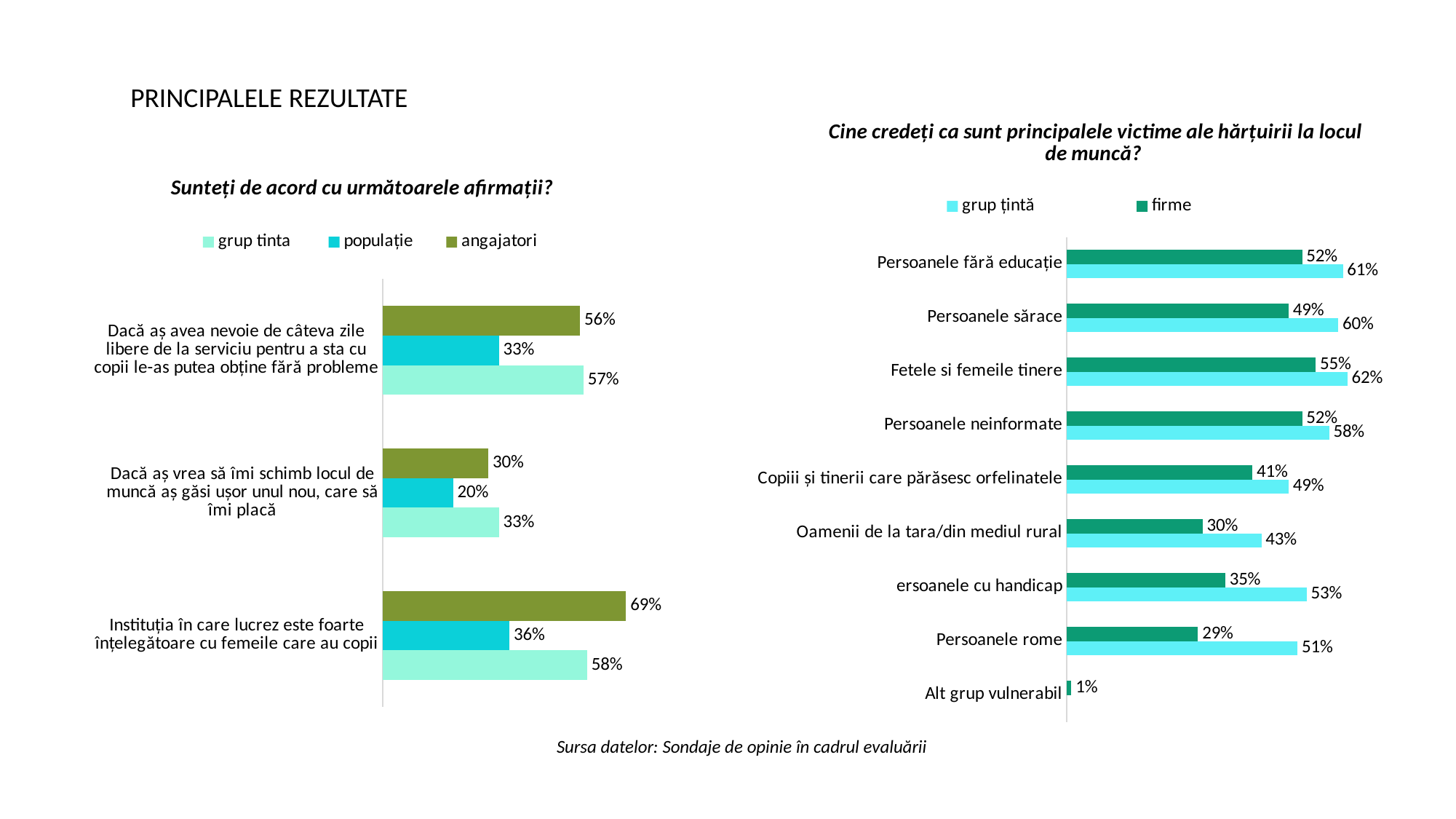
In the left chart 'Sunteți de acord cu următoarele afirmații?', what is the value for populație for 'Dacă aș vrea să îmi schimb locul de muncă aș găsi ușor unul nou, care să îmi placă'? 20% In the right chart 'Cine credeți ca sunt principalele victime ale hărțuirii la locul de muncă?', how many categories are shown? 9 In the right chart 'Cine credeți ca sunt principalele victime ale hărțuirii la locul de muncă?', what is the difference between the grup țintă and firme values for 'Persoanele rome'? 22% In the right chart 'Cine credeți ca sunt principalele victime ale hărțuirii la locul de muncă?', what is the firme value for 'Persoanele rome'? 29% In the right chart 'Cine credeți ca sunt principalele victime ale hărțuirii la locul de muncă?', which category has the highest firme value? Fetele si femeile tinere What kind of chart is the right chart 'Cine credeți ca sunt principalele victime ale hărțuirii la locul de muncă?'? bar chart In the left chart 'Sunteți de acord cu următoarele afirmații?', what is the value for angajatori for 'Instituția în care lucrez este foarte înțelegătoare cu femeile care au copii'? 69% In the right chart 'Cine credeți ca sunt principalele victime ale hărțuirii la locul de muncă?', what is the grup țintă value for 'Fetele si femeile tinere'? 62% In the left chart 'Sunteți de acord cu următoarele afirmații?', what is the difference between the angajatori and populație values for 'Dacă aș avea nevoie de câteva zile libere de la serviciu pentru a sta cu copii le-as putea obține fără probleme'? 23% In the right chart 'Cine credeți ca sunt principalele victime ale hărțuirii la locul de muncă?', which is larger for 'Oamenii de la tara/din mediul rural': grup țintă or firme? grup țintă In the left chart 'Sunteți de acord cu următoarele afirmații?', which statement has the lowest populație value? Dacă aș vrea să îmi schimb locul de muncă aș găsi ușor unul nou, care să îmi placă In the left chart 'Sunteți de acord cu următoarele afirmații?', how many series does the legend list? 3